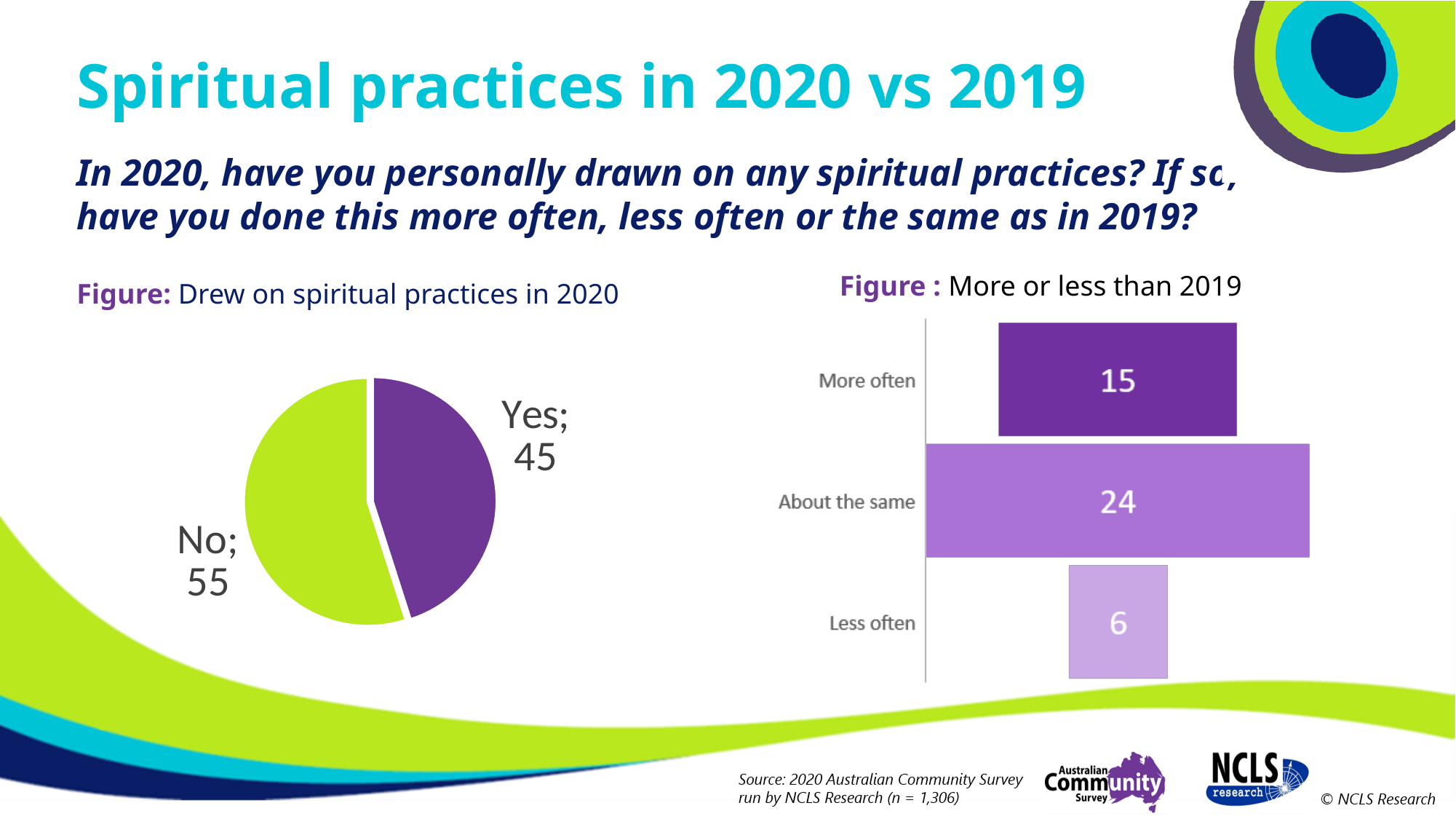
In the 'More or less than 2019' chart, what is the difference between More often and Less often? 9 How many categories are shown in the 'More or less than 2019' bar chart? 3 In the 'Drew on spiritual practices in 2020' pie chart, which slice is larger, Yes or No? No What kind of chart is the 'Drew on spiritual practices in 2020' figure? Pie chart In the 'Drew on spiritual practices in 2020' pie chart, what is the difference between the No and Yes values? 10 In the 'More or less than 2019' chart, what is the value for More often? 15 In the 'More or less than 2019' chart, which category has the lowest value? Less often In the 'More or less than 2019' chart, what is the value for Less often? 6 In the 'Drew on spiritual practices in 2020' pie chart, what is the value for No? 55 In the 'Drew on spiritual practices in 2020' pie chart, what is the value for Yes? 45 In the 'More or less than 2019' chart, what is the value for About the same? 24 In the 'More or less than 2019' chart, which category has the highest value? About the same